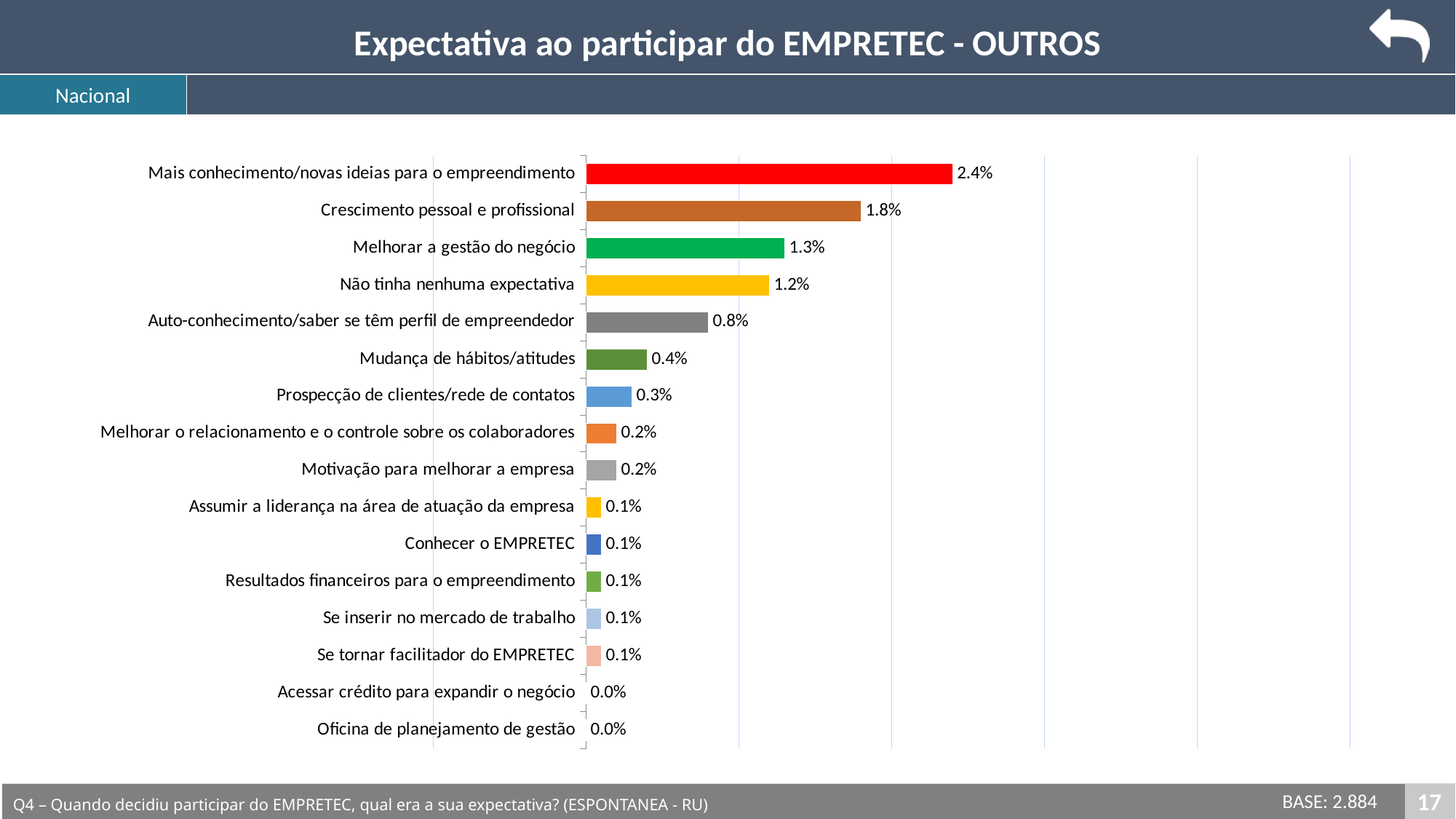
How many categories are shown in the chart? 16 What is the difference between the values for "Melhorar a gestão do negócio" and "Mudança de hábitos/atitudes"? 0.9% What is the value for "Prospecção de clientes/rede de contatos"? 0.3% How many categories have a value of 0.0%? 2 What is the title of the slide? Expectativa ao participar do EMPRETEC - OUTROS What is the value for "Crescimento pessoal e profissional"? 1.8% Which is larger, the value for "Não tinha nenhuma expectativa" or the value for "Auto-conhecimento/saber se têm perfil de empreendedor"? Não tinha nenhuma expectativa What is the value for "Mais conhecimento/novas ideias para o empreendimento"? 2.4% What is the difference between the values for "Mais conhecimento/novas ideias para o empreendimento" and "Crescimento pessoal e profissional"? 0.6% What is the value for "Auto-conhecimento/saber se têm perfil de empreendedor"? 0.8% What kind of chart is shown on the slide? Bar chart Which category has the highest value? Mais conhecimento/novas ideias para o empreendimento